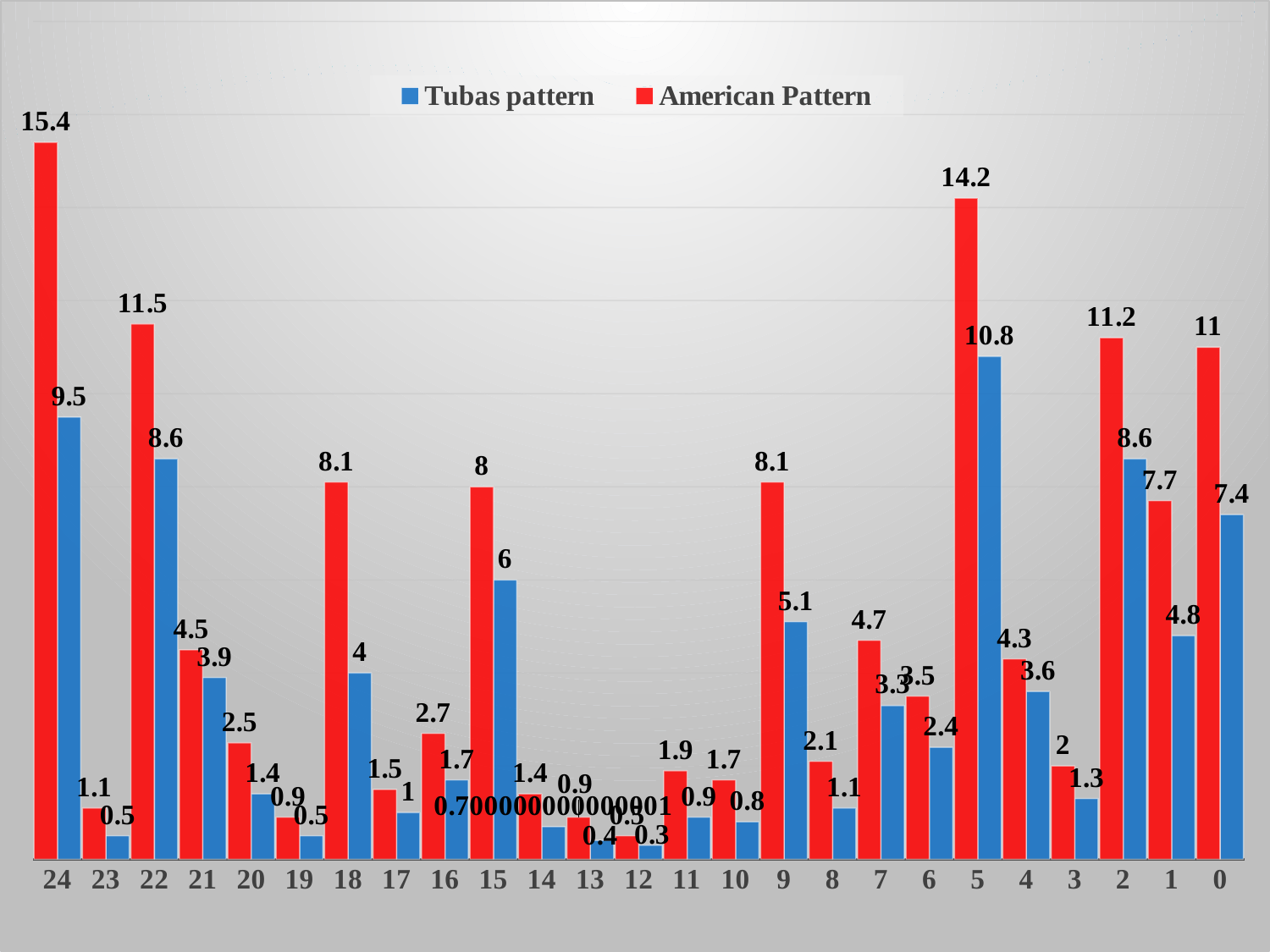
What kind of chart is shown on the slide? Bar chart Which category has the highest Tubas pattern value? 5 Which is larger for category 18, the Tubas pattern value or the American Pattern value? American Pattern How many series does the legend list? 2 What is the difference between the American Pattern values for category 5 and category 0? 3.2 Which category has the highest American Pattern value? 24 What is the American Pattern value for category 2? 11.2 How many categories are shown on the x axis? 25 What is the Tubas pattern value for category 5? 10.8 What is the Tubas pattern value for category 9? 5.1 What is the difference between the American Pattern and Tubas pattern values for category 24? 5.9 What is the American Pattern value for category 24? 15.4